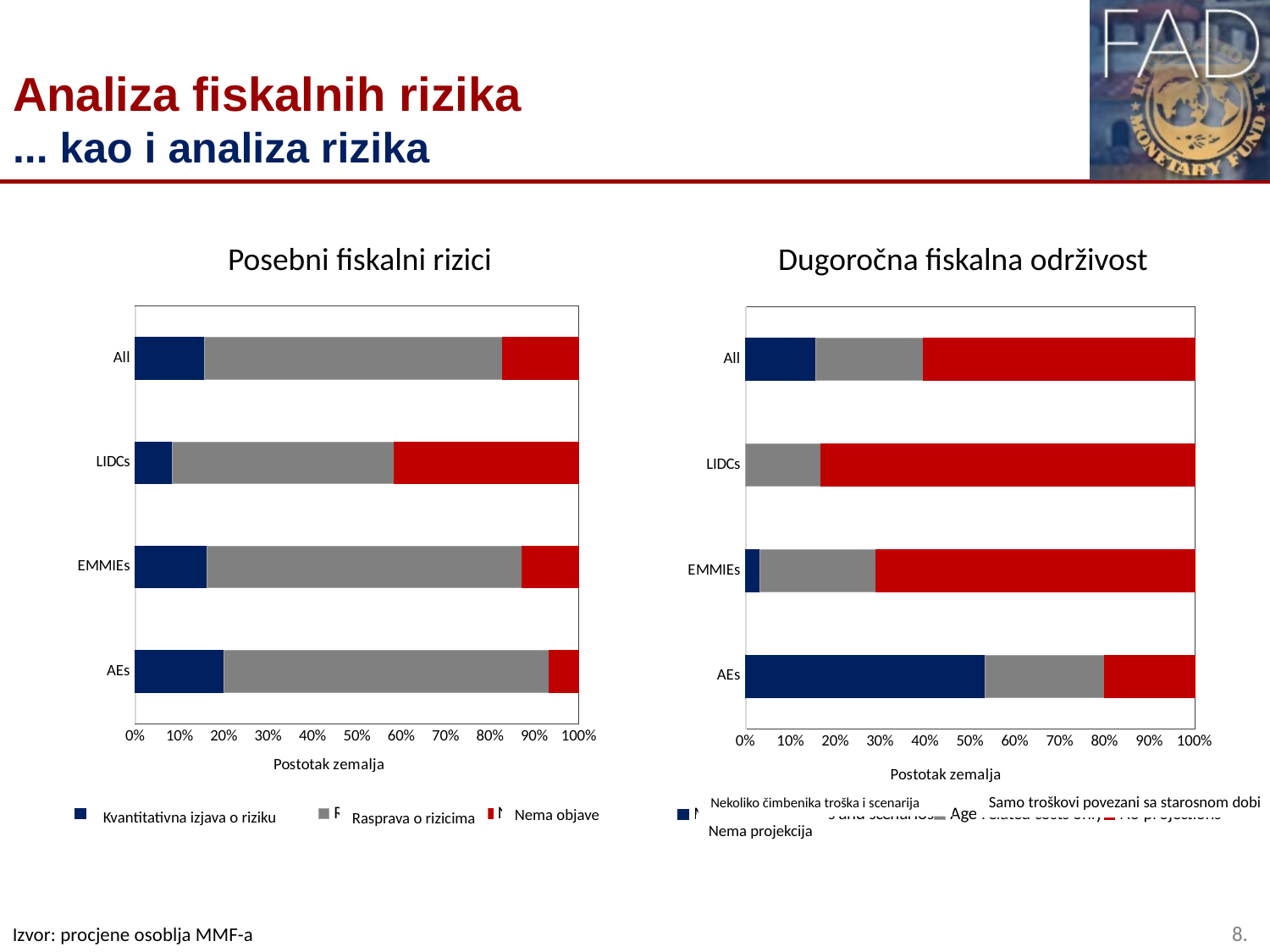
In the 'Dugoročna fiskalna održivost' chart, which category has the largest 'Nekoliko čimbenika troška i scenarija' share? AEs In the 'Dugoročna fiskalna održivost' chart, is the 'Nema projekcija' share for LIDCs greater or less than 70%? greater What is the x-axis label of the 'Dugoročna fiskalna održivost' chart? Postotak zemalja In the 'Posebni fiskalni rizici' chart, which category has the largest 'Nema objave' share? LIDCs How many categories are shown on the y axis of the 'Dugoročna fiskalna održivost' chart? 4 In the 'Posebni fiskalni rizici' chart, is the 'Nema objave' share for LIDCs greater or less than 30%? greater In the 'Dugoročna fiskalna održivost' chart, is the 'Nekoliko čimbenika troška i scenarija' share for AEs greater or less than 40%? greater How many series does the legend of the 'Posebni fiskalni rizici' chart list? 3 In the 'Posebni fiskalni rizici' chart, which has the larger 'Kvantitativna izjava o riziku' share, AEs or LIDCs? AEs In the 'Dugoročna fiskalna održivost' chart, which category has the smallest 'Nekoliko čimbenika troška i scenarija' share? LIDCs What kind of chart is the 'Posebni fiskalni rizici' chart? Stacked bar chart